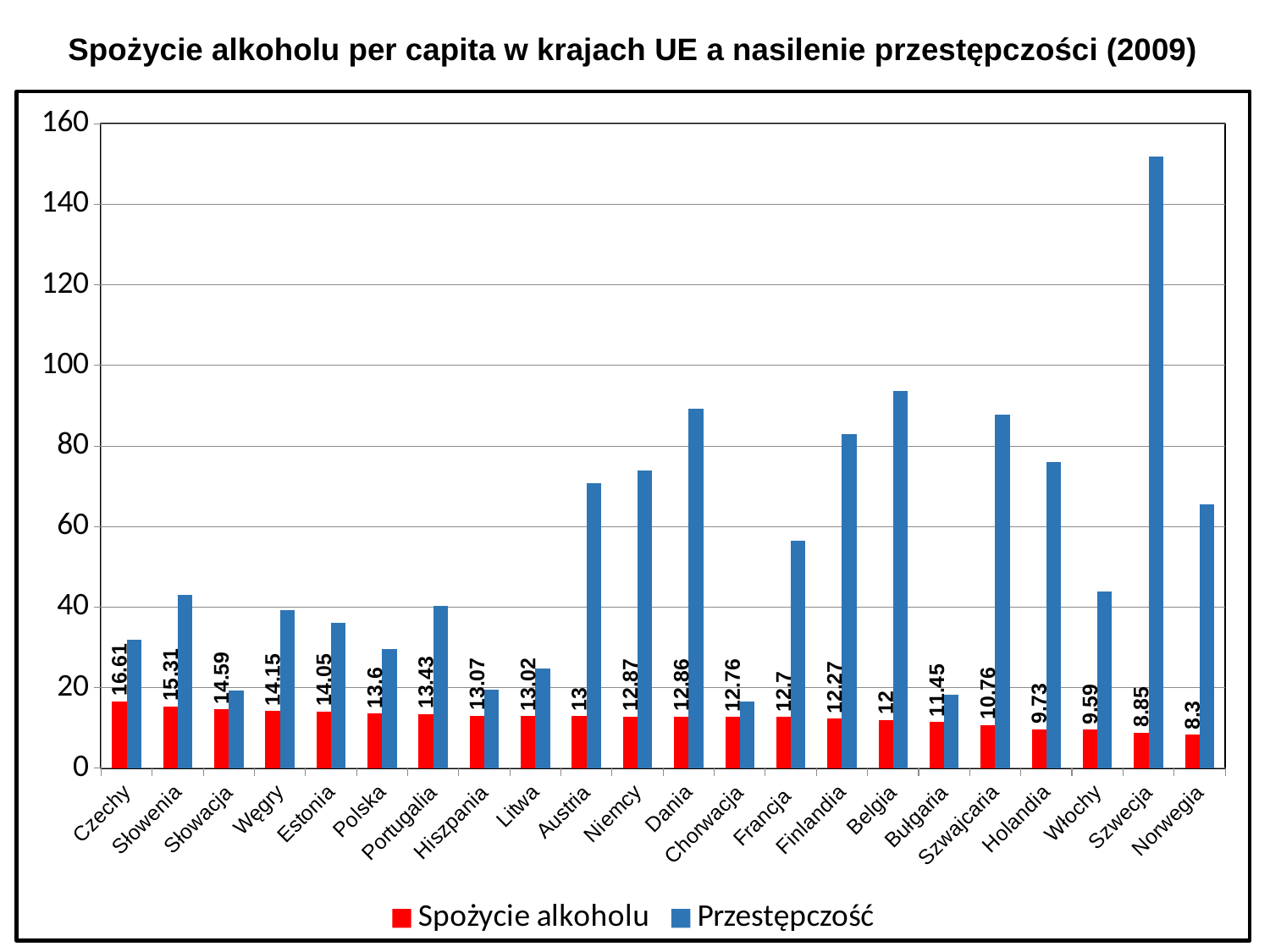
What is the difference between the Spożycie alkoholu values for Czechy and Norwegia? 8.31 How many countries are shown on the x axis? 22 Which country has the highest Spożycie alkoholu value? Czechy Which has the larger Spożycie alkoholu value, Węgry or Estonia? Węgry What is the value of Spożycie alkoholu for Czechy? 16.61 What is the value of Spożycie alkoholu for Polska? 13.6 Which country has the highest Przestępczość value? Szwecja Is the Przestępczość value for Chorwacja greater or less than 20? less What kind of chart is shown on the slide? bar chart How many series does the legend list? 2 Which country has the lowest Spożycie alkoholu value? Norwegia Is the Przestępczość value for Szwecja greater or less than 140? greater